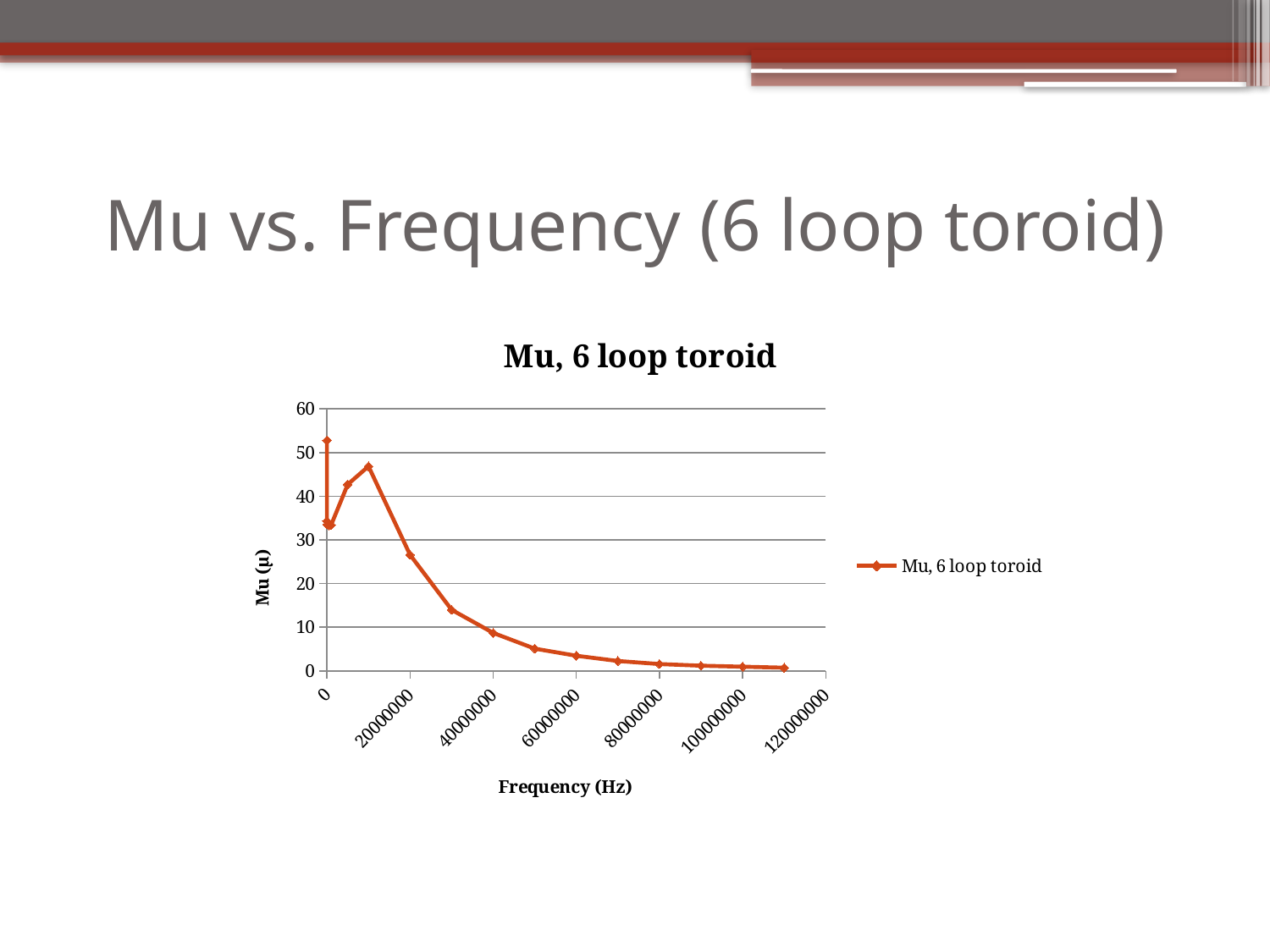
Which is larger, the Mu value at 20000000 Hz or the Mu value at 60000000 Hz? 20000000 Hz What is the title of the chart? Mu, 6 loop toroid Is the value of Mu at a frequency of 40000000 Hz greater or less than 10? less How many series does the legend list? 1 Is the highest plotted Mu value greater or less than 50? greater What kind of chart is shown on the slide? line chart Is the value of Mu at a frequency of 20000000 Hz greater or less than 30? less What is the maximum value shown on the y axis? 60 Do the Mu values rise or fall as frequency increases from 20000000 Hz to 120000000 Hz? fall What is the label of the x axis? Frequency (Hz)